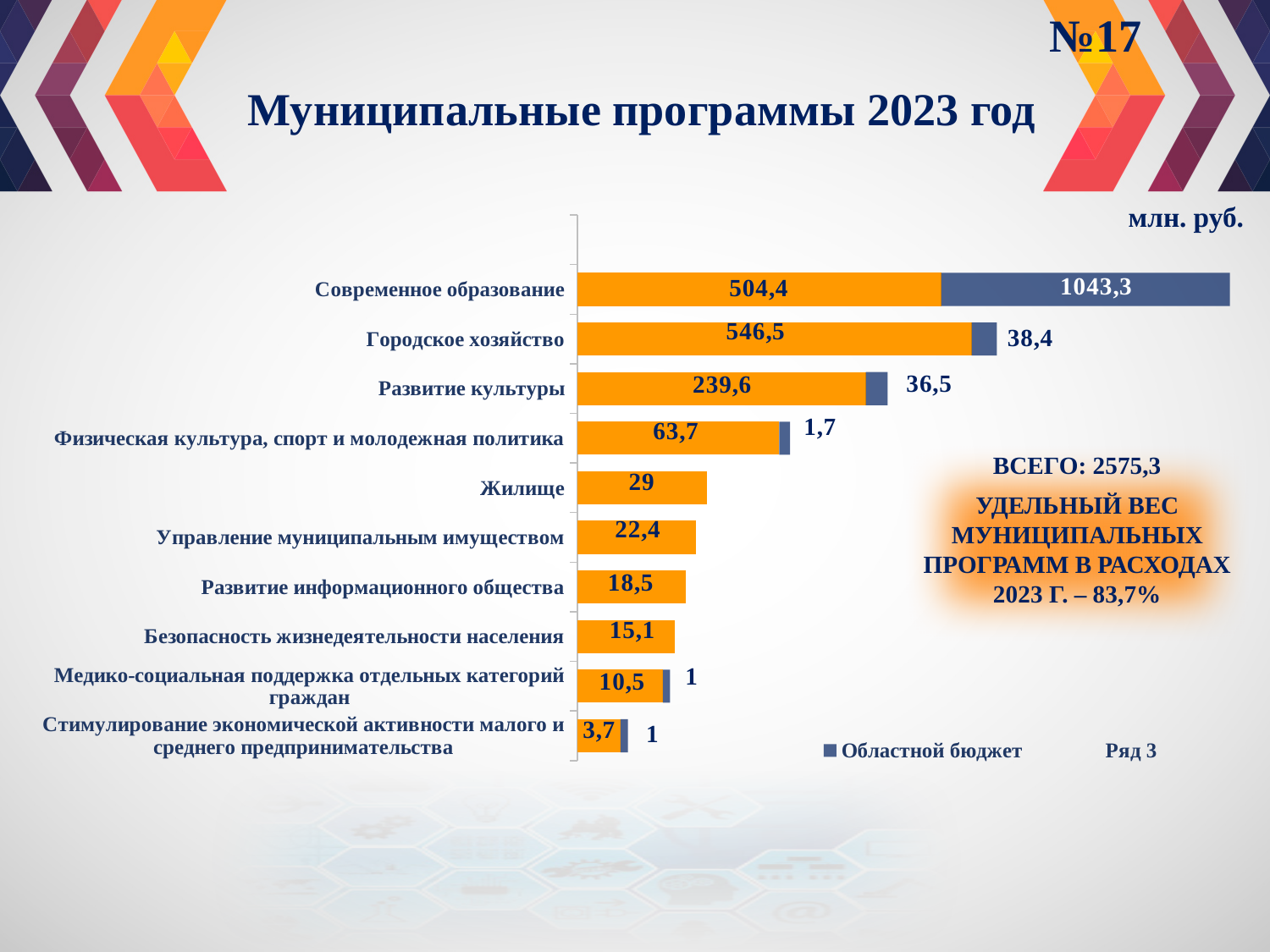
What is the total of the stacked bar for Современное образование? 1547,7 Which category has the smallest orange (Ряд 3) value? Стимулирование экономической активности малого и среднего предпринимательства Which category has the largest orange (Ряд 3) value? Городское хозяйство What is the Областной бюджет value for Современное образование? 1043,3 How many categories are shown in the chart? 10 What is the value of the orange (Ряд 3) bar for Городское хозяйство? 546,5 How many series does the legend list? 2 What type of chart is shown on the slide? Bar chart What is the value shown for Жилище? 29 What is the Областной бюджет value for Физическая культура, спорт и молодежная политика? 1,7 Which has the larger orange (Ряд 3) value: Развитие культуры or Физическая культура, спорт и молодежная политика? Развитие культуры What is the difference between the orange (Ряд 3) values for Городское хозяйство and Современное образование? 42,1